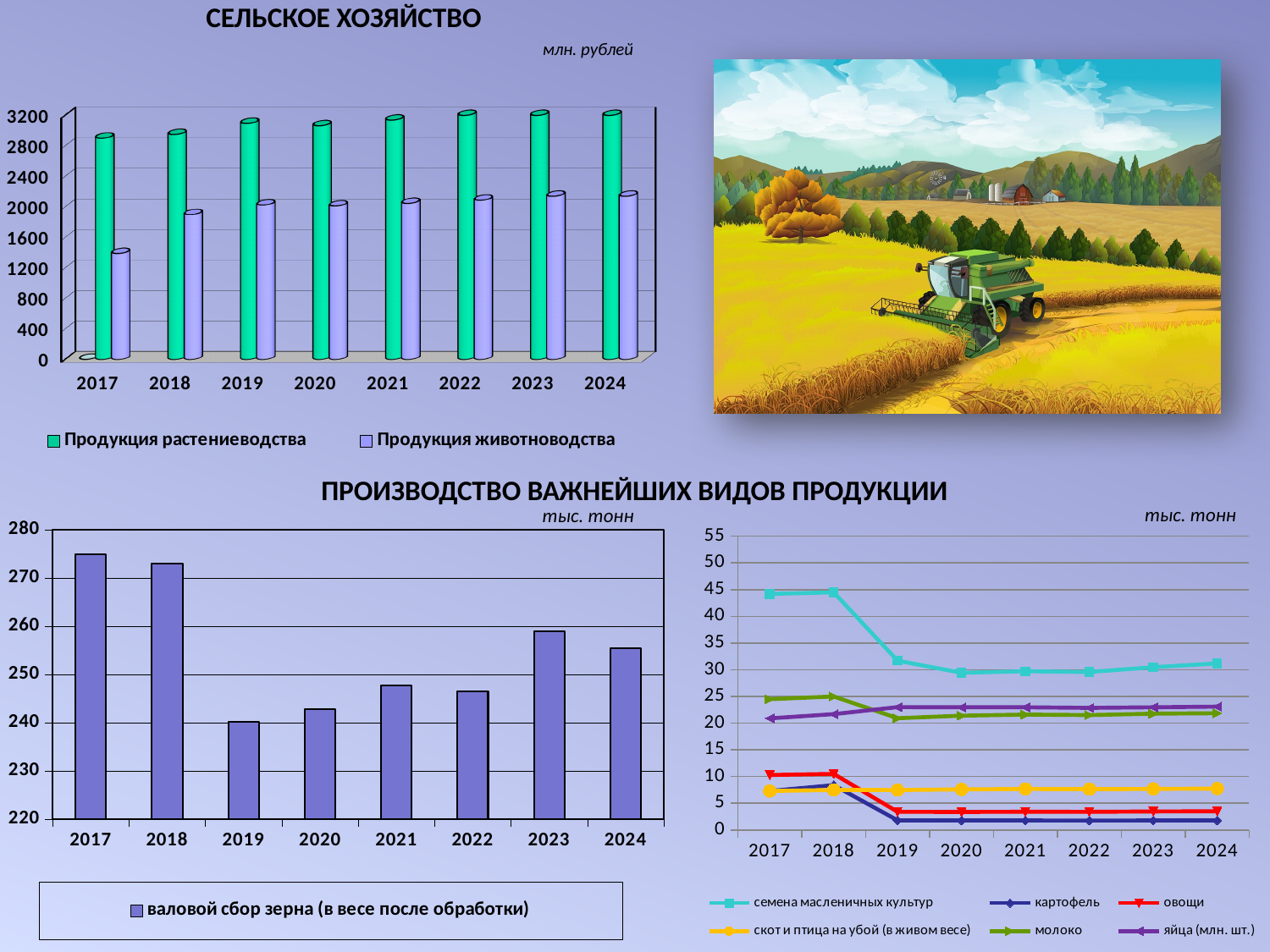
In the top-left chart 'СЕЛЬСКОЕ ХОЗЯЙСТВО', is the value of 'Продукция животноводства' for 2017 greater or less than 1600? less In the bottom-left chart 'валовой сбор зерна', is the value for 2019 greater or less than 250? less In the top-left chart 'СЕЛЬСКОЕ ХОЗЯЙСТВО', how many series does the legend list? 2 In the bottom-right line chart, how many series does the legend list? 6 In the bottom-right line chart, does the value for 'семена масленичных культур' rise or fall from 2017 to 2024? fall In the bottom-right line chart, is the value for 'семена масленичных культур' in 2017 greater or less than 40? greater What kind of chart is the top-left chart titled 'СЕЛЬСКОЕ ХОЗЯЙСТВО'? bar chart In the top-left chart 'СЕЛЬСКОЕ ХОЗЯЙСТВО', in which year is 'Продукция животноводства' lowest? 2017 In the bottom-left chart 'валовой сбор зерна', which year has the lowest value? 2019 In the bottom-left chart 'валовой сбор зерна', which year has the highest value? 2017 In the top-left chart 'СЕЛЬСКОЕ ХОЗЯЙСТВО', which is larger in 2017: 'Продукция растениеводства' or 'Продукция животноводства'? Продукция растениеводства In the bottom-left chart 'валовой сбор зерна', how many years are shown on the x axis? 8